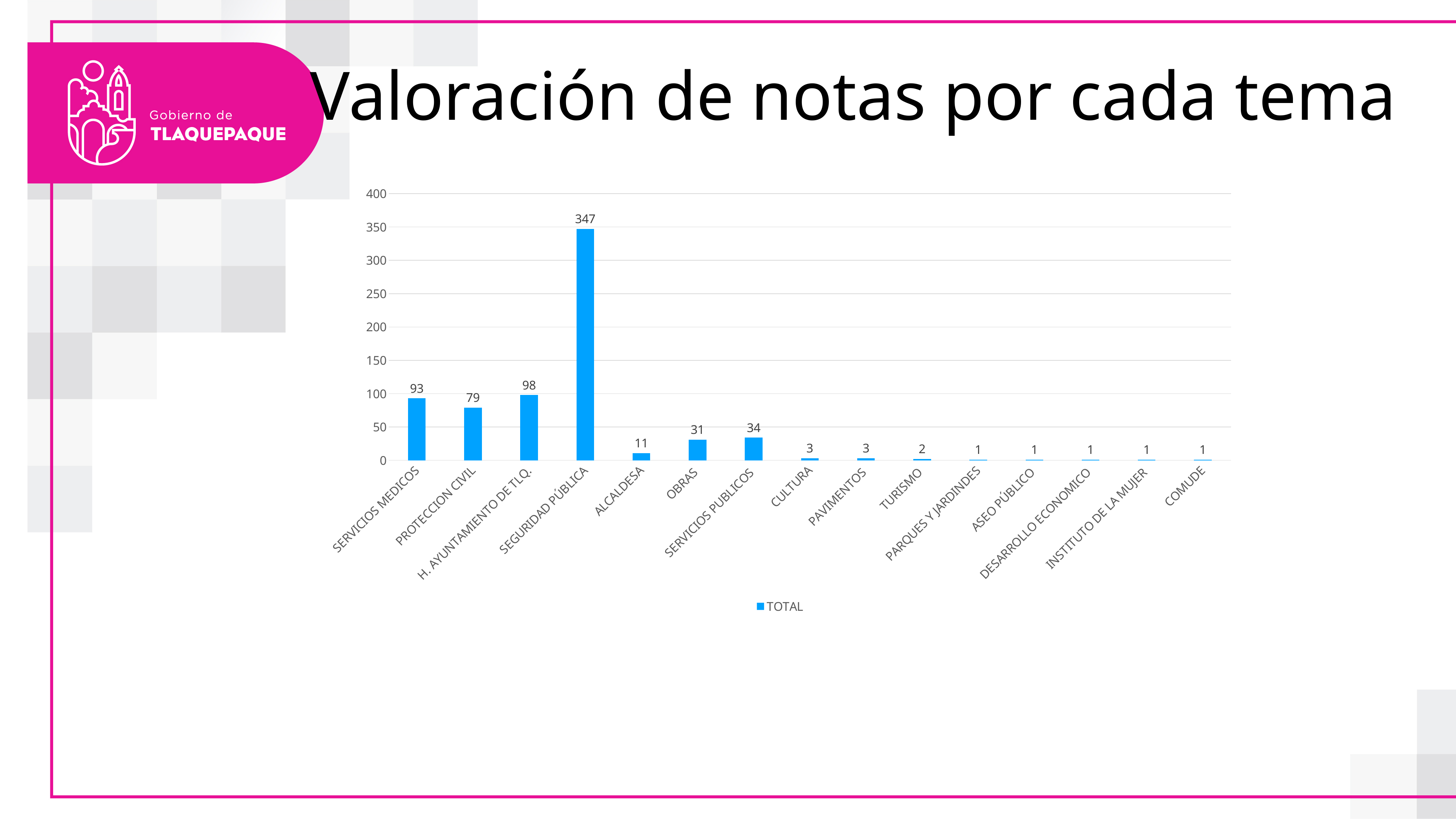
What is the difference between the values for SEGURIDAD PÚBLICA and H. AYUNTAMIENTO DE TLQ.? 249 What is the value for PROTECCION CIVIL? 79 How many categories are shown on the x axis? 15 How many series does the legend list? 1 Is the value for SEGURIDAD PÚBLICA greater or less than 300? greater Which category has the highest value? SEGURIDAD PÚBLICA What is the value for SEGURIDAD PÚBLICA? 347 What kind of chart is shown on the slide? Bar chart What is the value for SERVICIOS PUBLICOS? 34 What is the value for ALCALDESA? 11 Which is larger, the value for OBRAS or the value for SERVICIOS PUBLICOS? SERVICIOS PUBLICOS What is the difference between the values for H. AYUNTAMIENTO DE TLQ. and SERVICIOS MEDICOS? 5